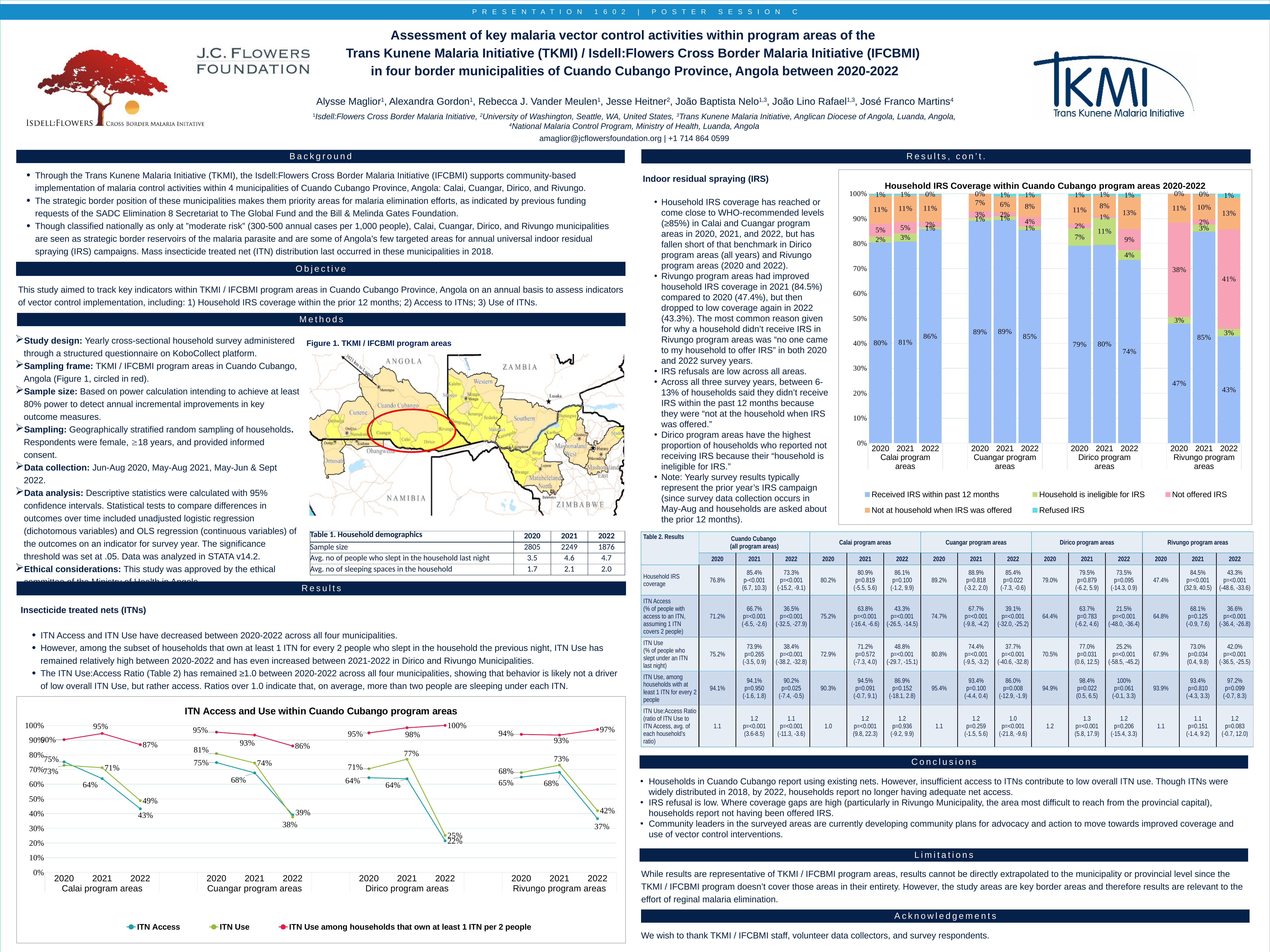
What kind of chart is the 'ITN Access and Use within Cuando Cubango program areas' chart? line chart What kind of chart is the 'Household IRS Coverage within Cuando Cubango program areas 2020-2022' chart? bar chart In the 'Household IRS Coverage within Cuando Cubango program areas 2020-2022' chart, which program area and year has the lowest share of 'Received IRS within past 12 months'? Rivungo program areas, 2022 How many program areas are shown along the x axis of the 'ITN Access and Use within Cuando Cubango program areas' chart? 4 In the 'Household IRS Coverage within Cuando Cubango program areas 2020-2022' chart, what share of households in Rivungo program areas in 2020 were 'Not offered IRS'? 38% In the 'ITN Access and Use within Cuando Cubango program areas' chart, what is the value of ITN Use among households that own at least 1 ITN per 2 people for Dirico program areas in 2022? 100% In the 'ITN Access and Use within Cuando Cubango program areas' chart, does ITN Access in Calai program areas rise or fall from 2020 to 2022? fall In the 'ITN Access and Use within Cuando Cubango program areas' chart, which is higher in 2022: ITN Use in Calai program areas or ITN Use in Cuangar program areas? Calai program areas In the 'Household IRS Coverage within Cuando Cubango program areas 2020-2022' chart, by how many percentage points did 'Received IRS within past 12 months' in Rivungo program areas drop from 2021 to 2022? 42 percentage points In the 'ITN Access and Use within Cuando Cubango program areas' chart, what is the ITN Access value for Dirico program areas in 2022? 22% How many series does the legend of the 'Household IRS Coverage within Cuando Cubango program areas 2020-2022' chart list? 5 How many series does the legend of the 'ITN Access and Use within Cuando Cubango program areas' chart list? 3